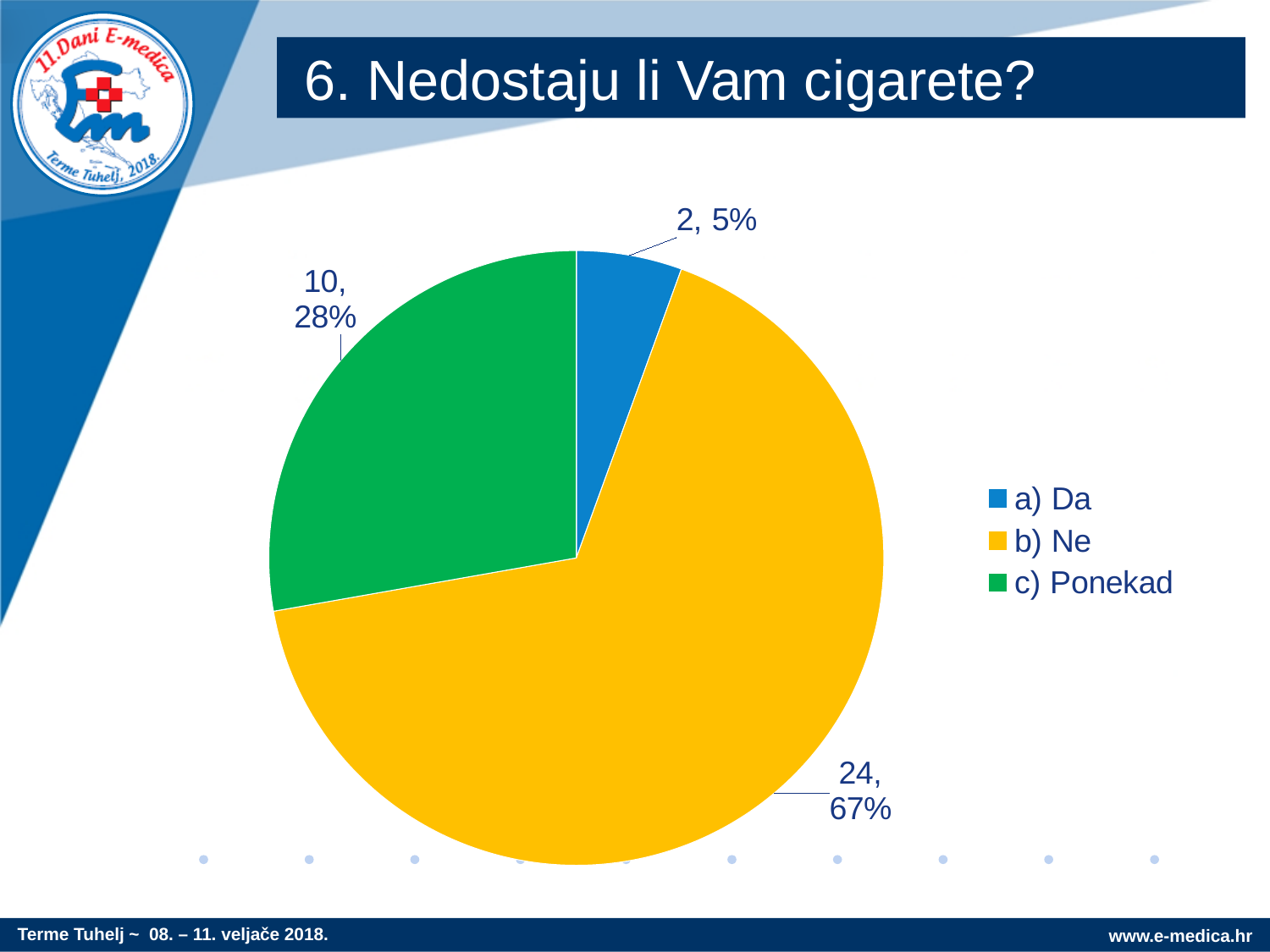
What share of the pie does "b) Ne" represent? 67% Which category has the largest slice? b) Ne What colour is the slice for "c) Ponekad"? green What is the count for "b) Ne"? 24 What is the count for "c) Ponekad"? 10 What share of the pie does "c) Ponekad" represent? 28% What is the difference between the counts for "b) Ne" and "c) Ponekad"? 14 What is the count for "a) Da"? 2 How many entries does the legend list? 3 Which category has the smallest slice? a) Da What kind of chart is shown on the slide? pie chart How many slices does the pie chart have? 3